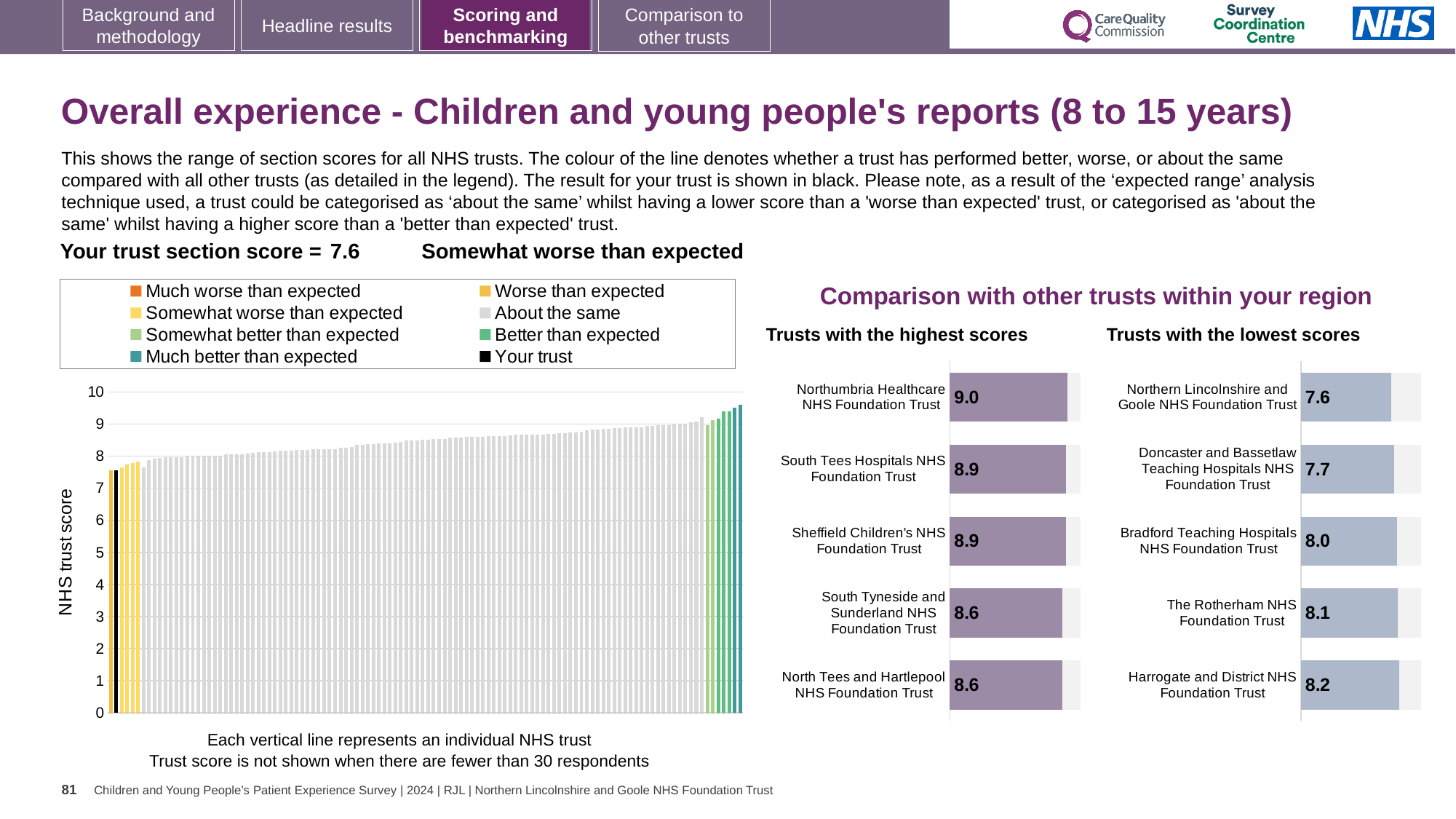
In the large chart on the left showing all NHS trusts, is the value for your trust (the black bar) greater or less than 8? less In the 'Trusts with the lowest scores' chart, which trust has the lowest score? Northern Lincolnshire and Goole NHS Foundation Trust In the 'Trusts with the highest scores' chart, what is the difference between the scores of Northumbria Healthcare NHS Foundation Trust and North Tees and Hartlepool NHS Foundation Trust? 0.4 In the 'Trusts with the lowest scores' chart, which has the higher score: The Rotherham NHS Foundation Trust or Doncaster and Bassetlaw Teaching Hospitals NHS Foundation Trust? The Rotherham NHS Foundation Trust In the 'Trusts with the highest scores' chart, how many trusts are listed? 5 In the large chart on the left showing all NHS trusts, do the values rise or fall from left to right? rise In the 'Trusts with the lowest scores' chart, what is the difference between the scores of Harrogate and District NHS Foundation Trust and Northern Lincolnshire and Goole NHS Foundation Trust? 0.6 What is the y-axis label of the large chart on the left? NHS trust score How many entries does the legend above the large chart on the left list? 8 In the 'Trusts with the highest scores' chart, what is the score for Northumbria Healthcare NHS Foundation Trust? 9.0 In the 'Trusts with the highest scores' chart, which trust has the highest score? Northumbria Healthcare NHS Foundation Trust In the 'Trusts with the lowest scores' chart, what is the score for Bradford Teaching Hospitals NHS Foundation Trust? 8.0